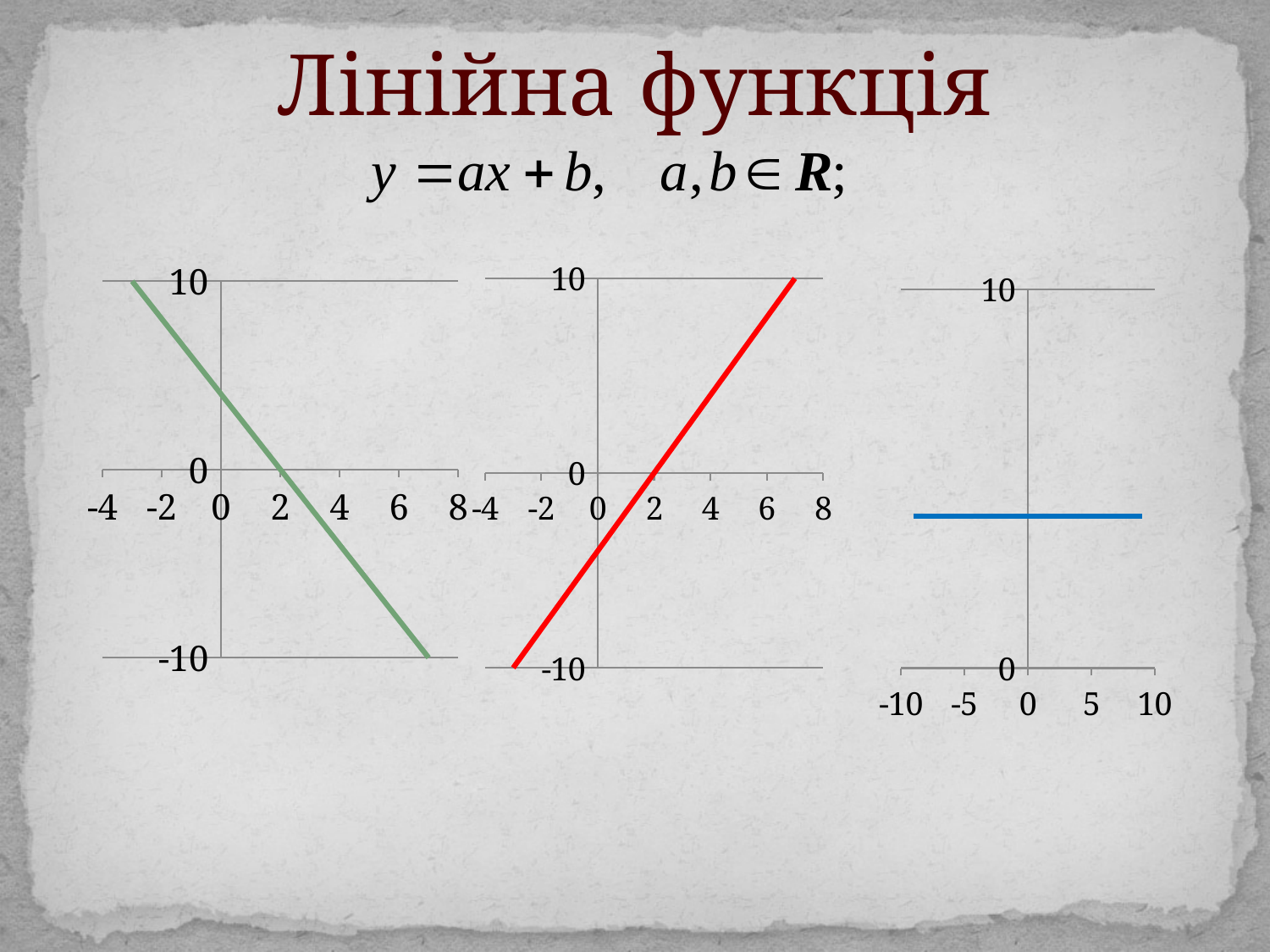
In the left chart, is the value of the line at x = 6 greater or less than 0? less In the middle chart, is the value of the line at x = 6 greater or less than 0? greater In the right chart, do the values rise, fall or stay constant as x increases? stay constant In the left chart, is the value of the line at x = 0 greater or less than 0? greater What colour is the line in the middle chart? red What colour is the line in the left chart? green What kind of chart is the left chart on the slide? line chart In the middle chart, do the values rise or fall as x increases? rise In the left chart, do the values rise or fall as x increases? fall